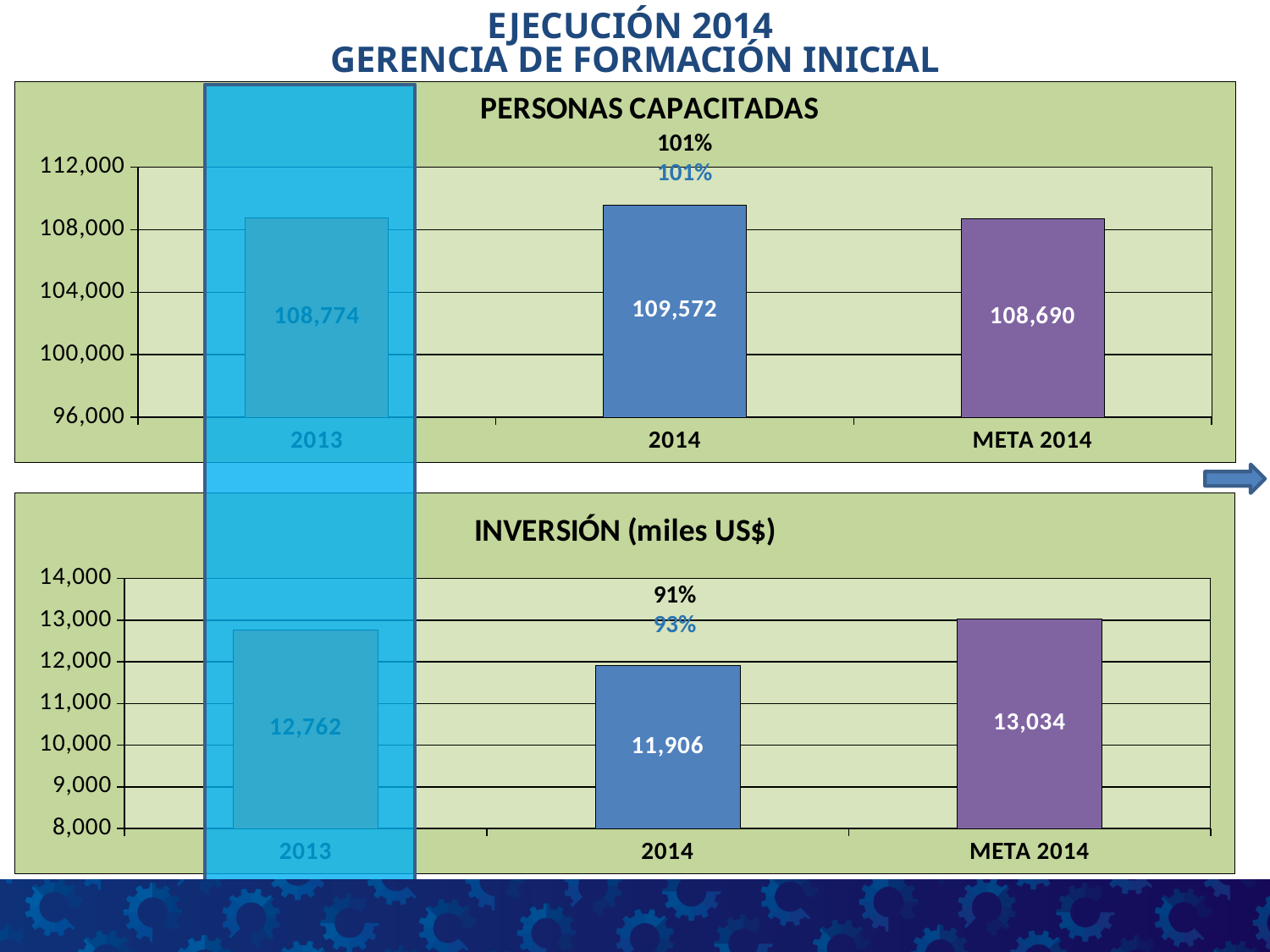
In the INVERSIÓN (miles US$) chart, which category has the lowest value? 2014 How many categories are shown in the INVERSIÓN (miles US$) chart? 3 In the PERSONAS CAPACITADAS chart, what is the value for 2013? 108,774 In the PERSONAS CAPACITADAS chart, what is the difference between the 2014 value and the META 2014 value? 882 In the INVERSIÓN (miles US$) chart, what is the value for 2014? 11,906 In the INVERSIÓN (miles US$) chart, what is the difference between the META 2014 value and the 2014 value? 1,128 In the INVERSIÓN (miles US$) chart, what is the value for META 2014? 13,034 In the INVERSIÓN (miles US$) chart, which is larger, the value for 2013 or the value for META 2014? META 2014 In the PERSONAS CAPACITADAS chart, what is the value for META 2014? 108,690 In the PERSONAS CAPACITADAS chart, what is the value for 2014? 109,572 In the PERSONAS CAPACITADAS chart, which category has the highest value? 2014 What kind of chart is the PERSONAS CAPACITADAS chart? Bar chart